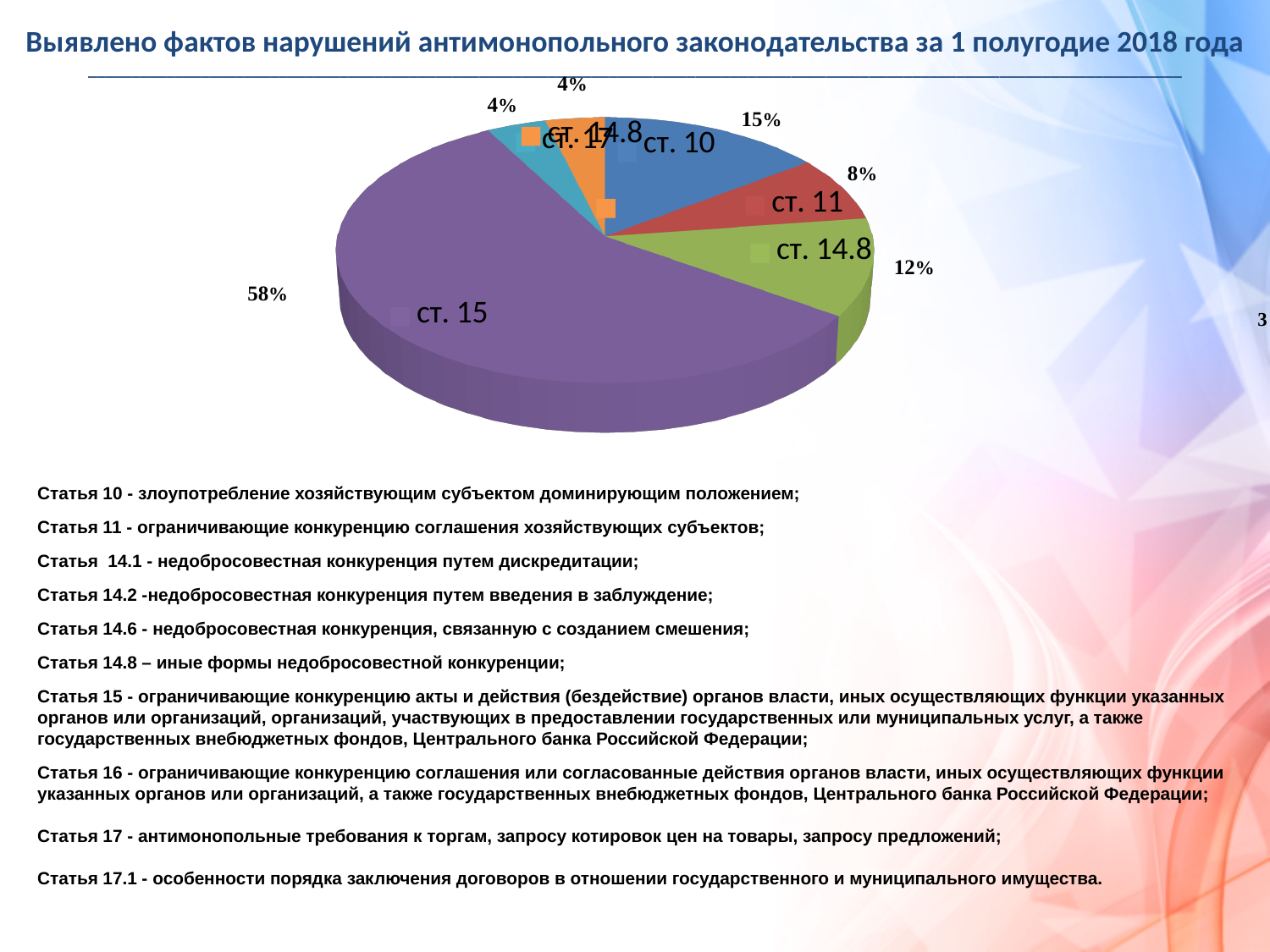
How many slices does the pie chart have? 6 What kind of chart is shown on the slide? pie chart What is the difference in percentage points between the ст. 15 slice and the ст. 10 slice? 43% What is the value shown for ст. 11? 8% What is the title of the slide containing the pie chart? Выявлено фактов нарушений антимонопольного законодательства за 1 полугодие 2018 года What is the value shown for the green slice labelled ст. 14.8? 12% What share of the pie does ст. 15 account for? 58% What is the value shown for ст. 10? 15% Which slice of the pie is the largest? ст. 15 Which is larger, the slice for ст. 10 or the slice for ст. 11? ст. 10 What colour is the largest slice of the pie chart? purple What is the difference in percentage points between the ст. 14.8 slice and the ст. 11 slice? 4%